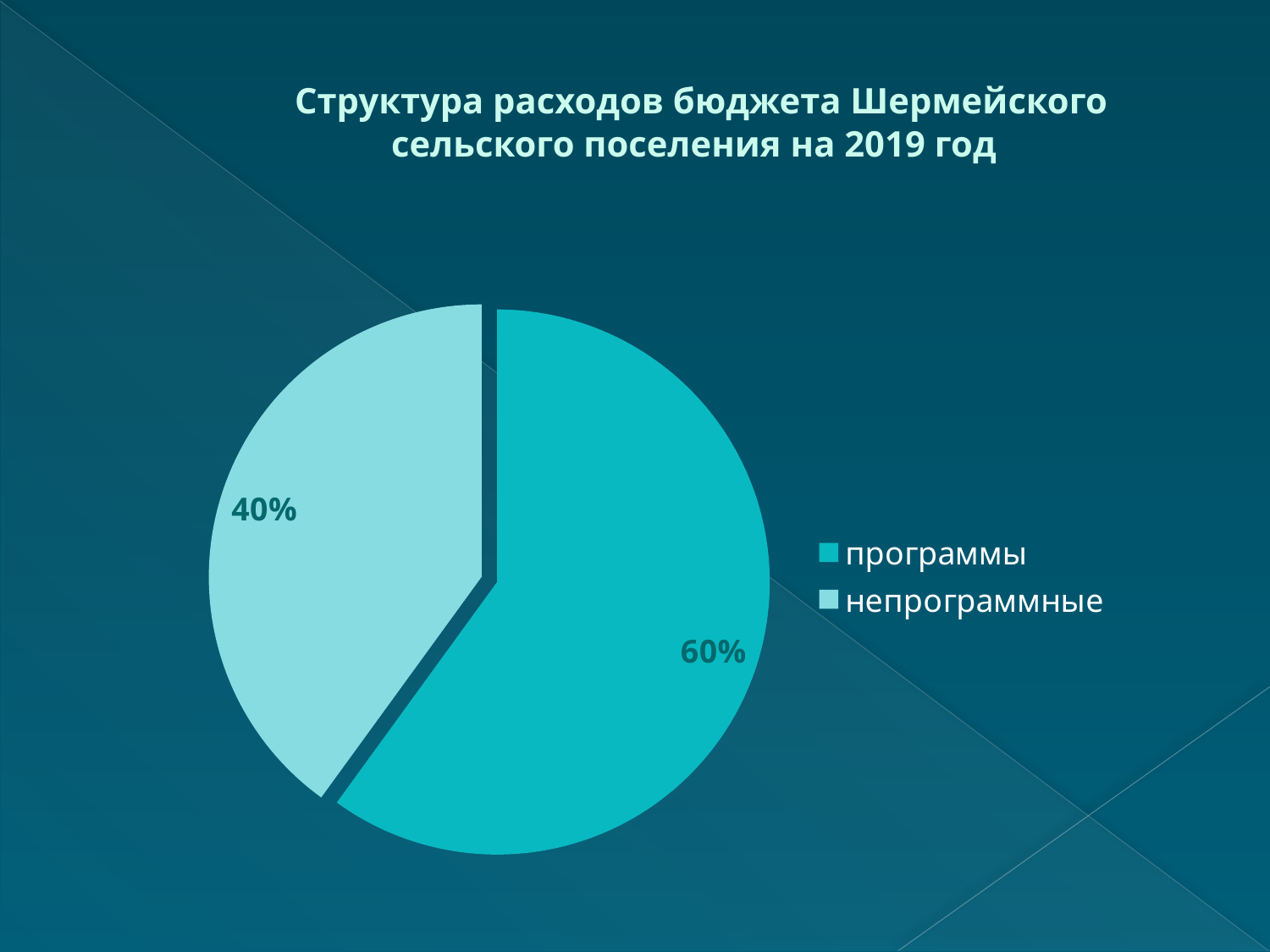
What share of the pie does the "программы" slice represent? 60% How many slices does the pie chart have? 2 Which legend entry is shown in the lighter colour? непрограммные What share of the pie does the "непрограммные" slice represent? 40% What kind of chart is shown on the slide? pie chart Which category has the smallest slice of the pie? непрограммные Which is larger, the "программы" slice or the "непрограммные" slice? программы What is the title of the chart? Структура расходов бюджета Шермейского сельского поселения на 2019 год What is the difference in percentage points between the "программы" and "непрограммные" slices? 20% How many entries does the legend list? 2 Which category has the largest slice of the pie? программы